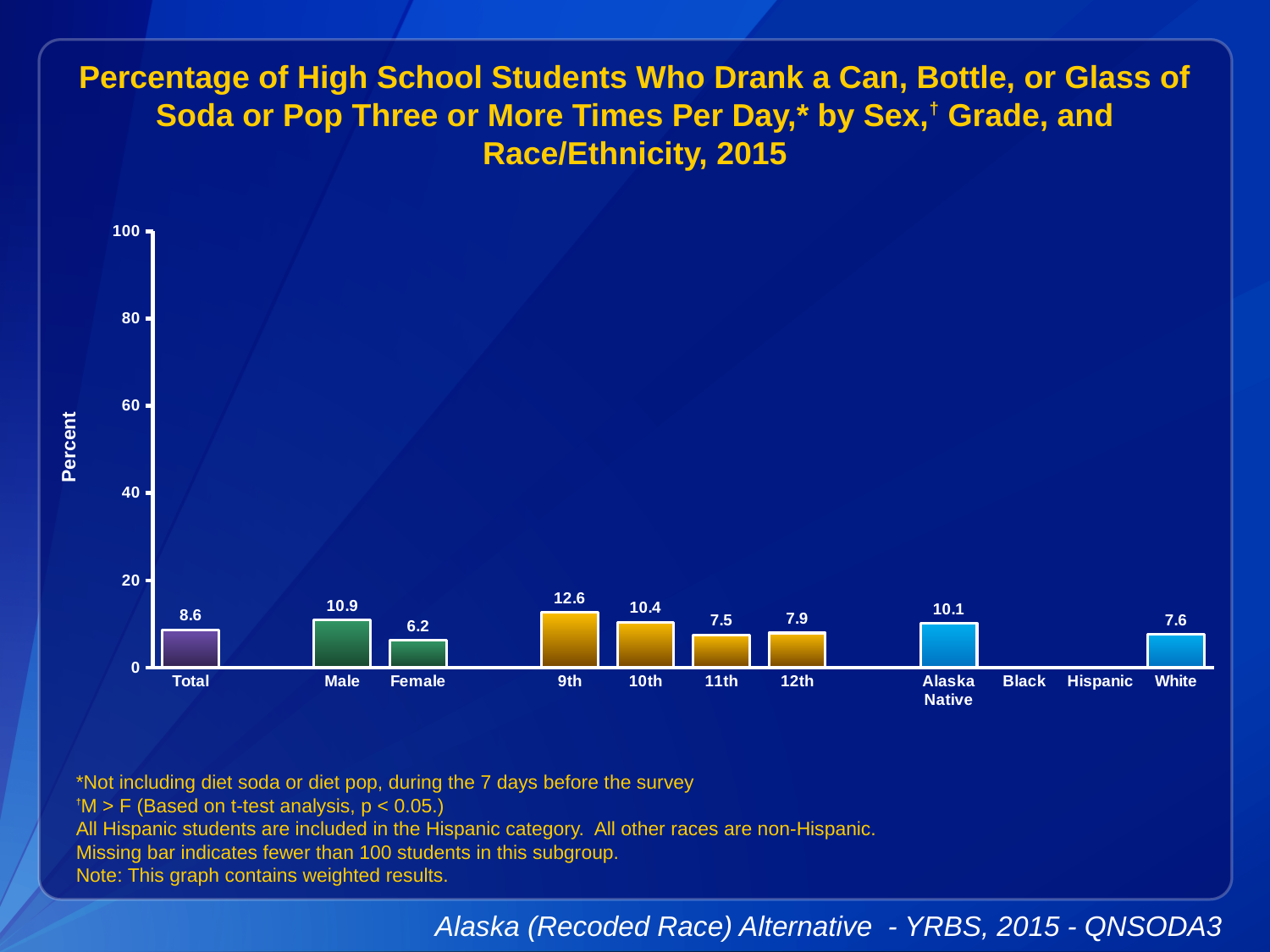
Which is larger, the value for 10th grade or the value for 12th grade? 10th Which category has the highest value? 9th How many categories are labeled on the x axis? 11 Is the value for 11th grade greater or less than 20? less What is the value for Total? 8.6 What is the value for Male? 10.9 What is the difference between the Male and Female values? 4.7 What kind of chart is shown? bar chart What is the value for 9th grade? 12.6 What is the value for Alaska Native? 10.1 Among the categories with a bar shown, which has the lowest value? Female What is the value for Female? 6.2